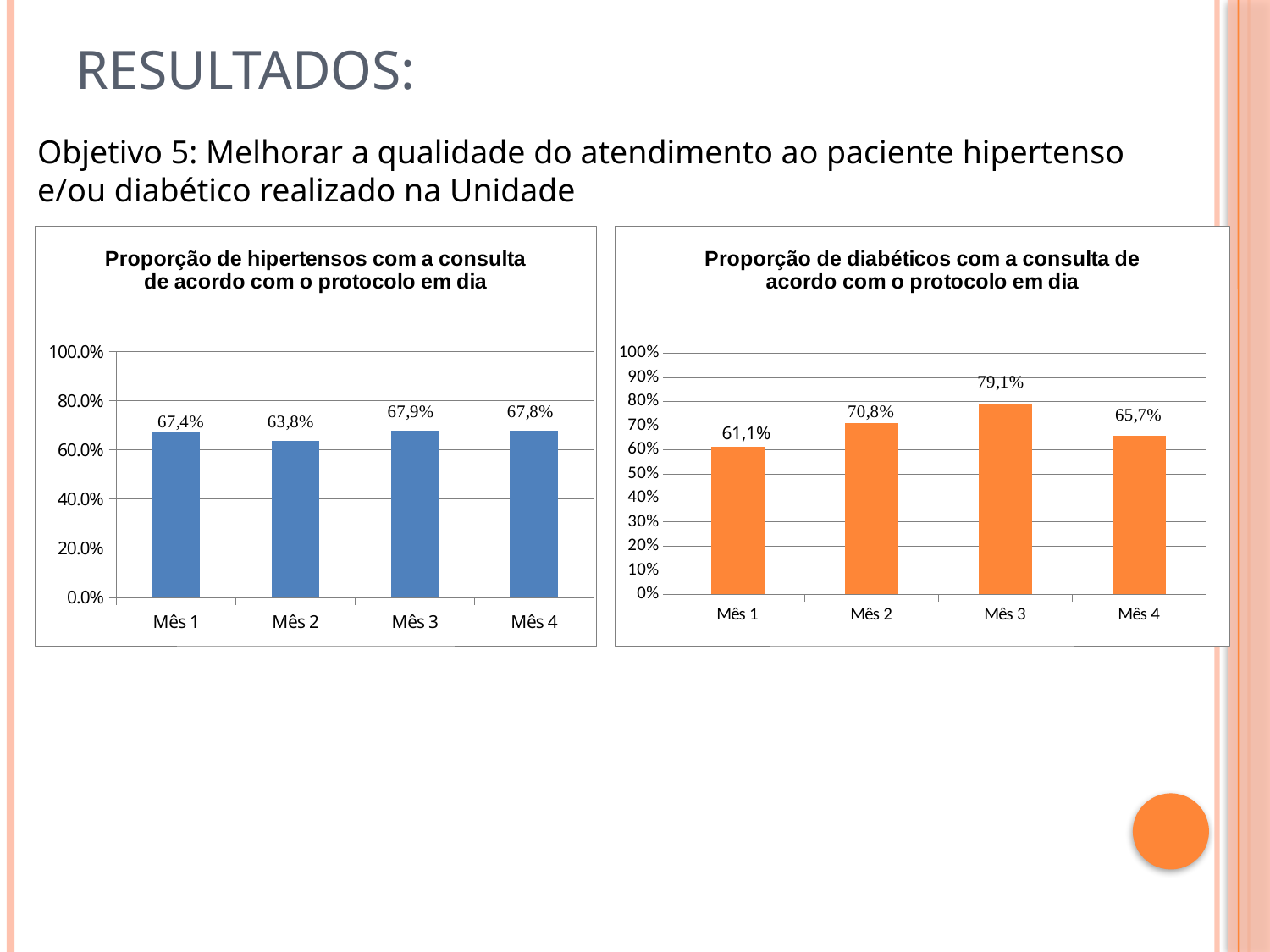
In the chart 'Proporção de hipertensos com a consulta de acordo com o protocolo em dia', is the value for Mês 3 greater or less than 80.0%? less In the chart 'Proporção de diabéticos com a consulta de acordo com o protocolo em dia', which month has the highest value? Mês 3 In the chart 'Proporção de diabéticos com a consulta de acordo com o protocolo em dia', what is the value for Mês 3? 79,1% In the chart 'Proporção de hipertensos com a consulta de acordo com o protocolo em dia', what is the difference between the values for Mês 1 and Mês 2? 3,6 percentage points In the chart 'Proporção de hipertensos com a consulta de acordo com o protocolo em dia', which month has the lowest value? Mês 2 In the chart 'Proporção de diabéticos com a consulta de acordo com o protocolo em dia', which month has the lowest value? Mês 1 In the chart 'Proporção de diabéticos com a consulta de acordo com o protocolo em dia', what is the value for Mês 1? 61,1% How many months are shown in the chart 'Proporção de diabéticos com a consulta de acordo com o protocolo em dia'? 4 In the chart 'Proporção de hipertensos com a consulta de acordo com o protocolo em dia', what is the value for Mês 2? 63,8% In the chart 'Proporção de diabéticos com a consulta de acordo com o protocolo em dia', which is larger, the value for Mês 2 or Mês 4? Mês 2 In the chart 'Proporção de diabéticos com a consulta de acordo com o protocolo em dia', what is the difference between the values for Mês 3 and Mês 1? 18,0 percentage points What type of chart is 'Proporção de hipertensos com a consulta de acordo com o protocolo em dia'? Bar chart